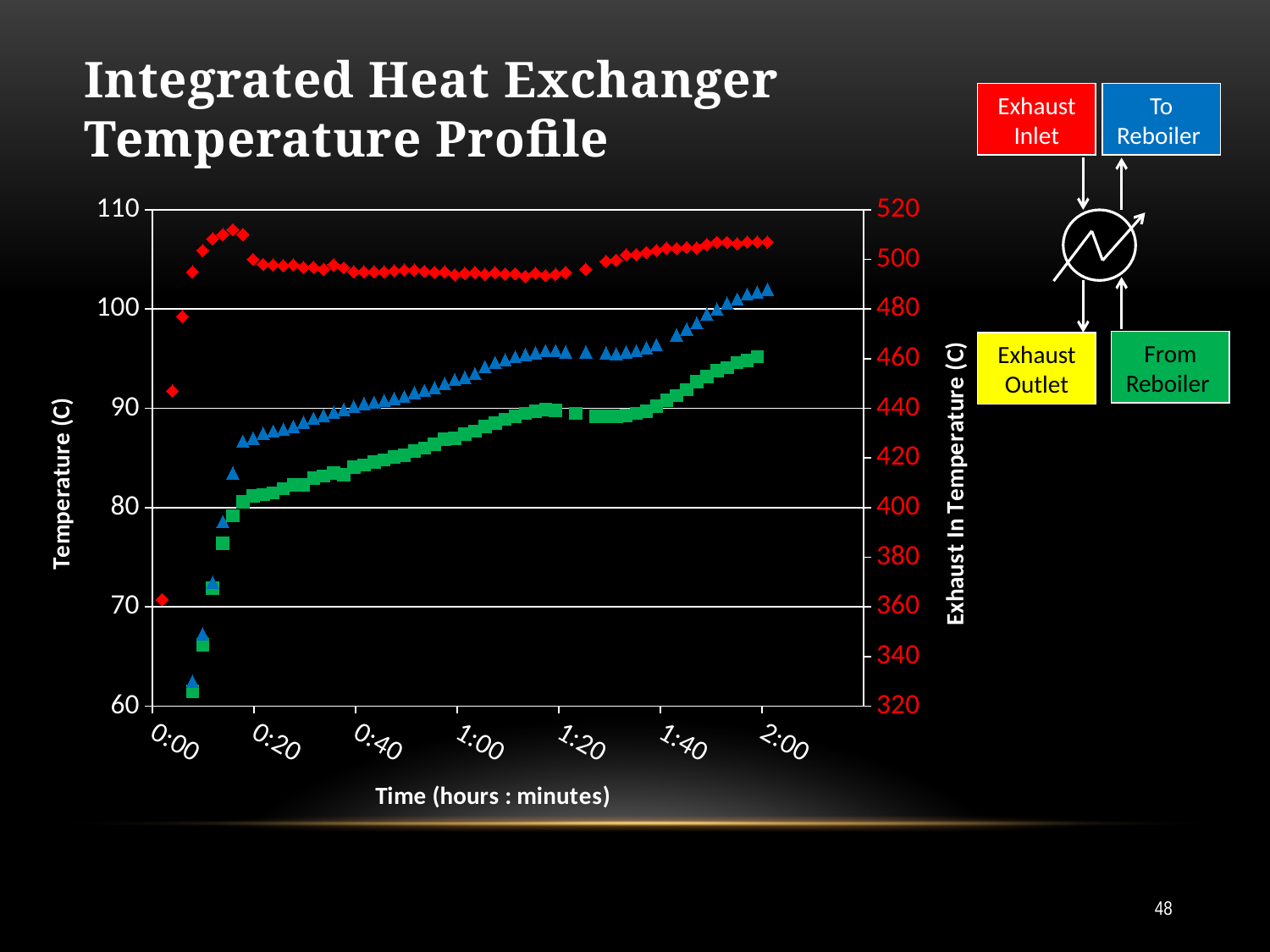
Is the peak value of the red diamond series near 0:10 greater or less than 500 on the right axis? greater Does the green square series generally rise or fall between 0:20 and 2:00? rise Is the value of the green square series at 2:00 greater or less than 90 on the left axis? greater Is the value of the green square series at 1:00 greater or less than 90 on the left axis? less What is the title of the chart on the slide? Integrated Heat Exchanger Temperature Profile Does the blue triangle series generally rise or fall from 0:00 to 2:00? rise How many data series are plotted on the chart? 3 At 1:00, which series has the higher value on the left axis, the blue triangles or the green squares? Blue triangles What kind of chart is shown on the slide? Scatter chart What is the label of the x axis of the chart? Time (hours : minutes)